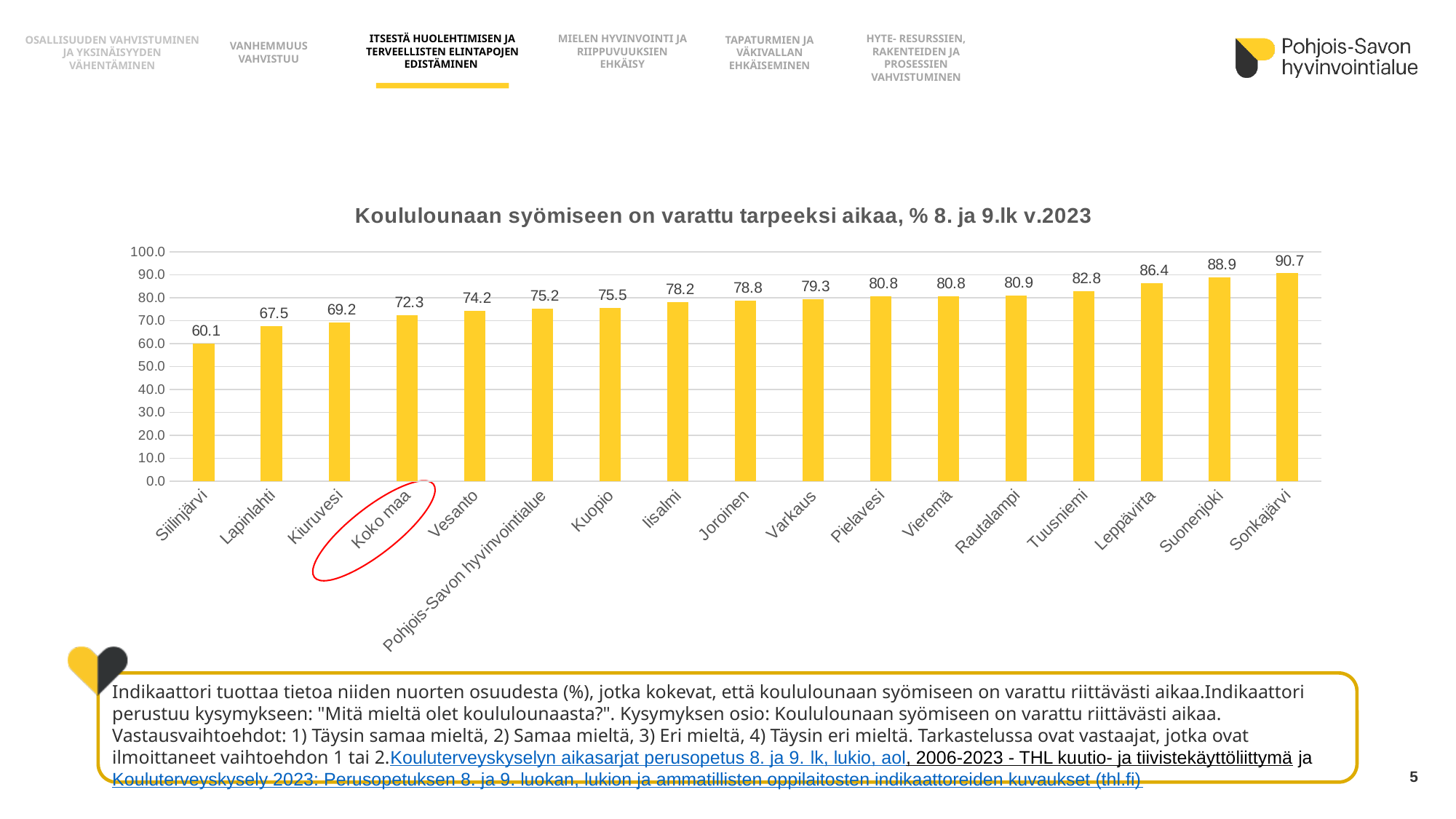
Which has a larger value, Leppävirta or Tuusniemi? Leppävirta Which category has the highest value? Sonkajärvi Do the values rise or fall from left to right along the x axis? Rise What is the value for Pohjois-Savon hyvinvointialue? 75.2 What is the value for Koko maa? 72.3 What kind of chart is shown on the slide? Bar chart Which category has the lowest value? Siilinjärvi How many categories are shown on the x axis? 17 What is the difference between the values for Pohjois-Savon hyvinvointialue and Koko maa? 2.9 What is the value for Kuopio? 75.5 What is the difference between the values for Sonkajärvi and Siilinjärvi? 30.6 Is the value for Lapinlahti greater or less than 70.0? less